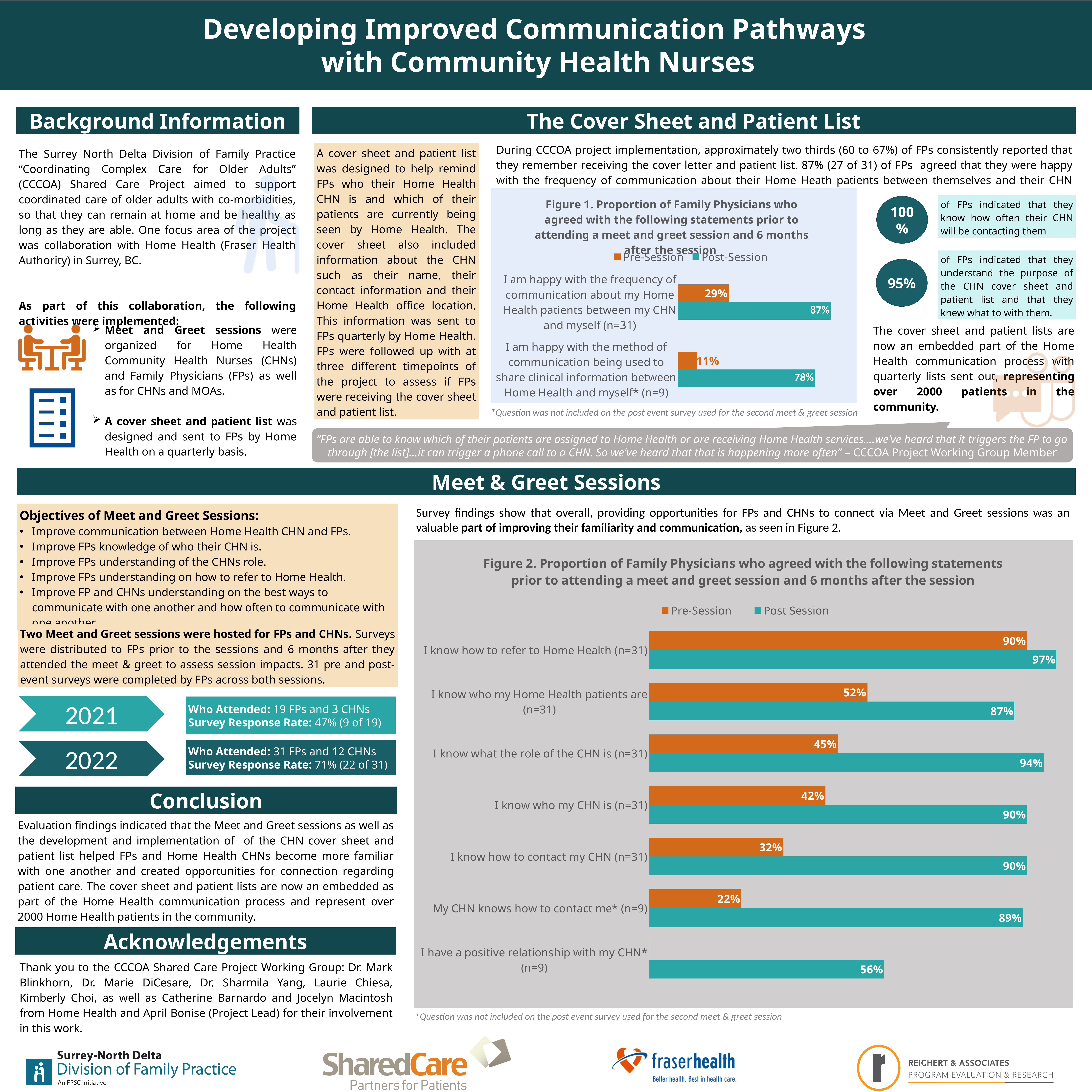
In Figure 1, what is the Pre-Session value for 'I am happy with the method of communication being used to share clinical information between Home Health and myself* (n=9)'? 11% In Figure 1, how many series does the legend list? 2 In Figure 2, which statement has the highest Post Session value? I know how to refer to Home Health (n=31) What type of chart is Figure 2? Bar chart In Figure 2, what is the Pre-Session value for 'I know who my Home Health patients are (n=31)'? 52% In Figure 2, which statement has the lowest Pre-Session value among those with a Pre-Session bar? My CHN knows how to contact me* (n=9) In Figure 1, what is the difference between the Post-Session and Pre-Session values for the statement about the frequency of communication? 58% In Figure 2, which is larger: the Pre-Session value for 'I know who my CHN is (n=31)' or the Pre-Session value for 'I know what the role of the CHN is (n=31)'? I know what the role of the CHN is (n=31) In Figure 2, how many statements (categories) are shown on the vertical axis? 7 In Figure 1, what is the Post-Session value for 'I am happy with the frequency of communication about my Home Health patients between my CHN and myself (n=31)'? 87% In Figure 2, what is the Post Session value for 'I know what the role of the CHN is (n=31)'? 94% In Figure 2, what is the difference between the Post Session and Pre-Session values for 'I know how to contact my CHN (n=31)'? 58%